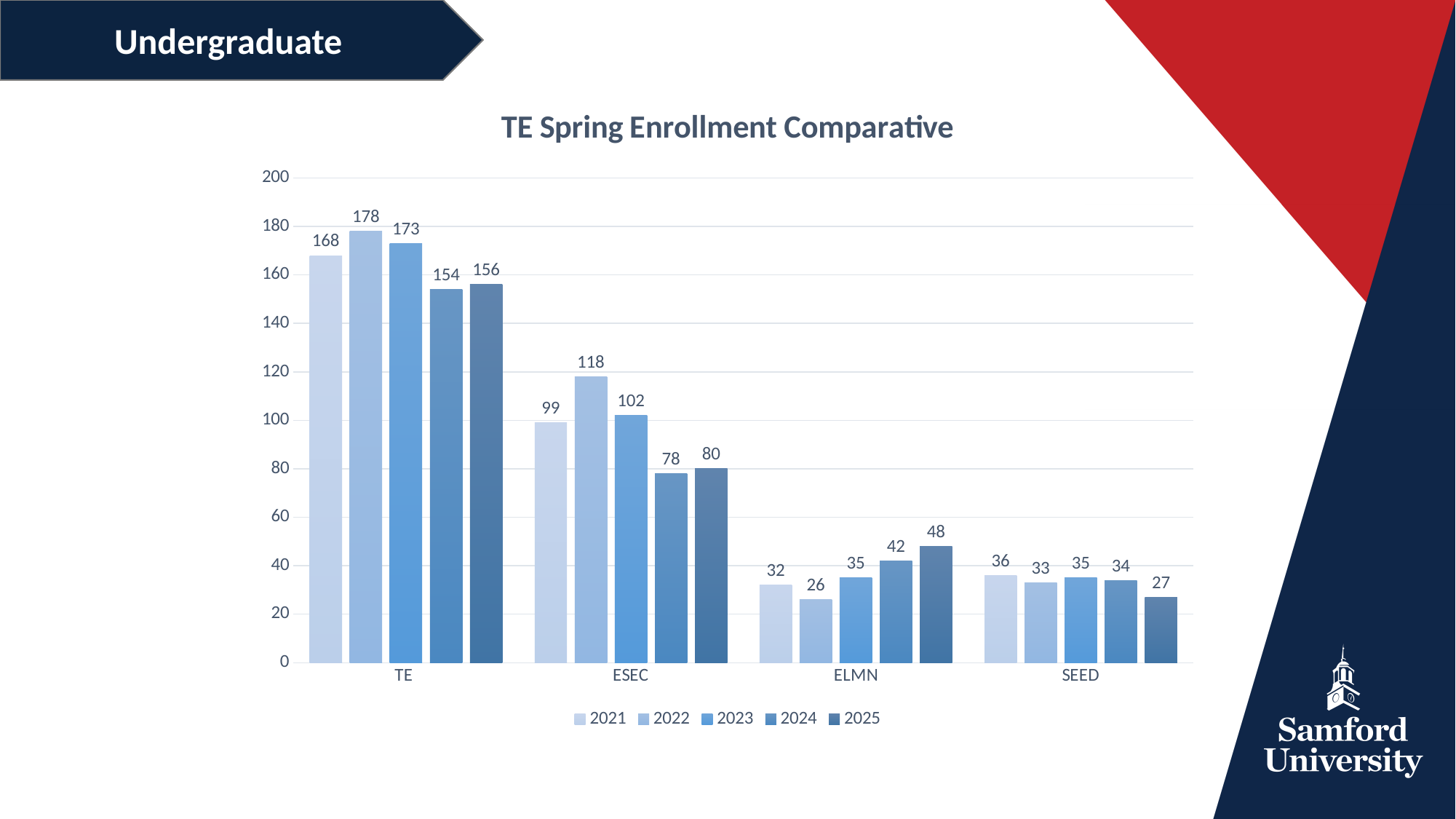
What is the 2025 value for ESEC? 80 Which is larger for SEED, the 2021 value or the 2023 value? 2021 How many categories are shown on the x axis? 4 How many series does the legend list? 5 What kind of chart is shown? Bar chart Which year has the lowest value for TE? 2024 What is the 2025 value for SEED? 27 What is the title of the chart? TE Spring Enrollment Comparative What is the 2022 value for TE? 178 Which year has the highest value for ELMN? 2025 What is the difference between the 2022 and 2024 values for ESEC? 40 What is the 2021 value for ELMN? 32